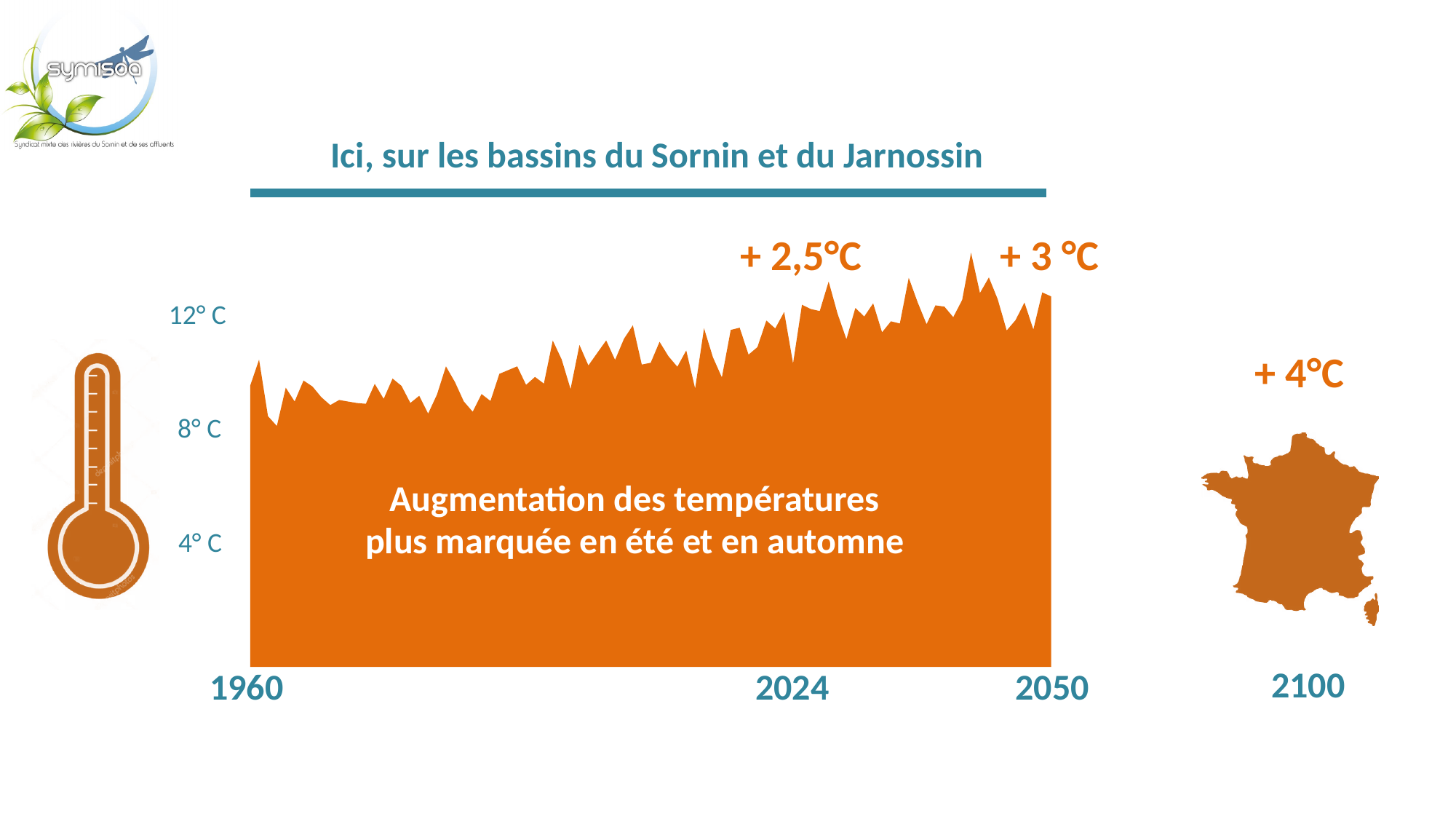
What is the highest temperature tick labelled on the y axis? 12° C Is the plotted temperature at the start of the series in 1960 greater or less than 12° C? less Which annotated increase is larger, the one for 2024 or the one for 2050? 2050 What temperature increase is annotated for 2100 next to the map of France? + 4°C What temperature increase is annotated on the chart for 2050? + 3 °C What is the first year labelled on the x axis of the chart? 1960 What temperature increase is annotated on the chart for 2024? + 2,5°C What is the title above the chart? Ici, sur les bassins du Sornin et du Jarnossin Is the plotted temperature around 1970 greater or less than 4° C? greater Do the plotted temperatures rise or fall from 1960 to 2050? rise What kind of chart is shown on the slide? area chart Is the plotted temperature near 2050 greater or less than 8° C? greater